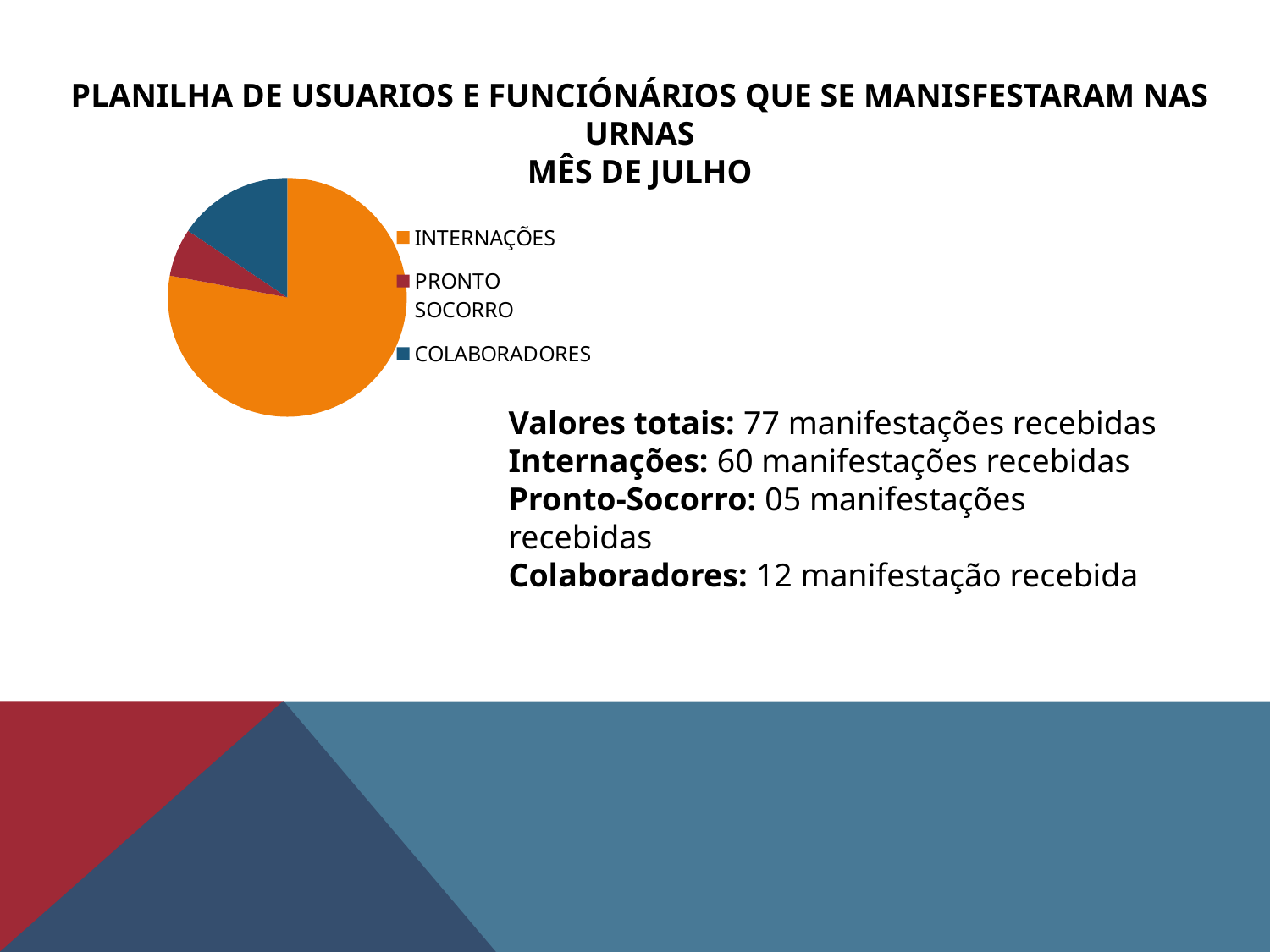
How many manifestações recebidas are reported for Colaboradores? 12 What is the total number of manifestações recebidas shown on the slide? 77 What colour is the INTERNAÇÕES slice in the pie chart? orange What is the difference between the Internações and Colaboradores values? 48 How many manifestações recebidas are reported for Internações? 60 How many manifestações recebidas are reported for Pronto-Socorro? 05 How many entries does the legend of the pie chart list? 3 How many slices does the pie chart have? 3 What kind of chart is shown on the slide? pie chart Which category has the smallest slice of the pie chart? PRONTO SOCORRO Which slice is larger, COLABORADORES or PRONTO SOCORRO? COLABORADORES Which category has the largest slice of the pie chart? INTERNAÇÕES